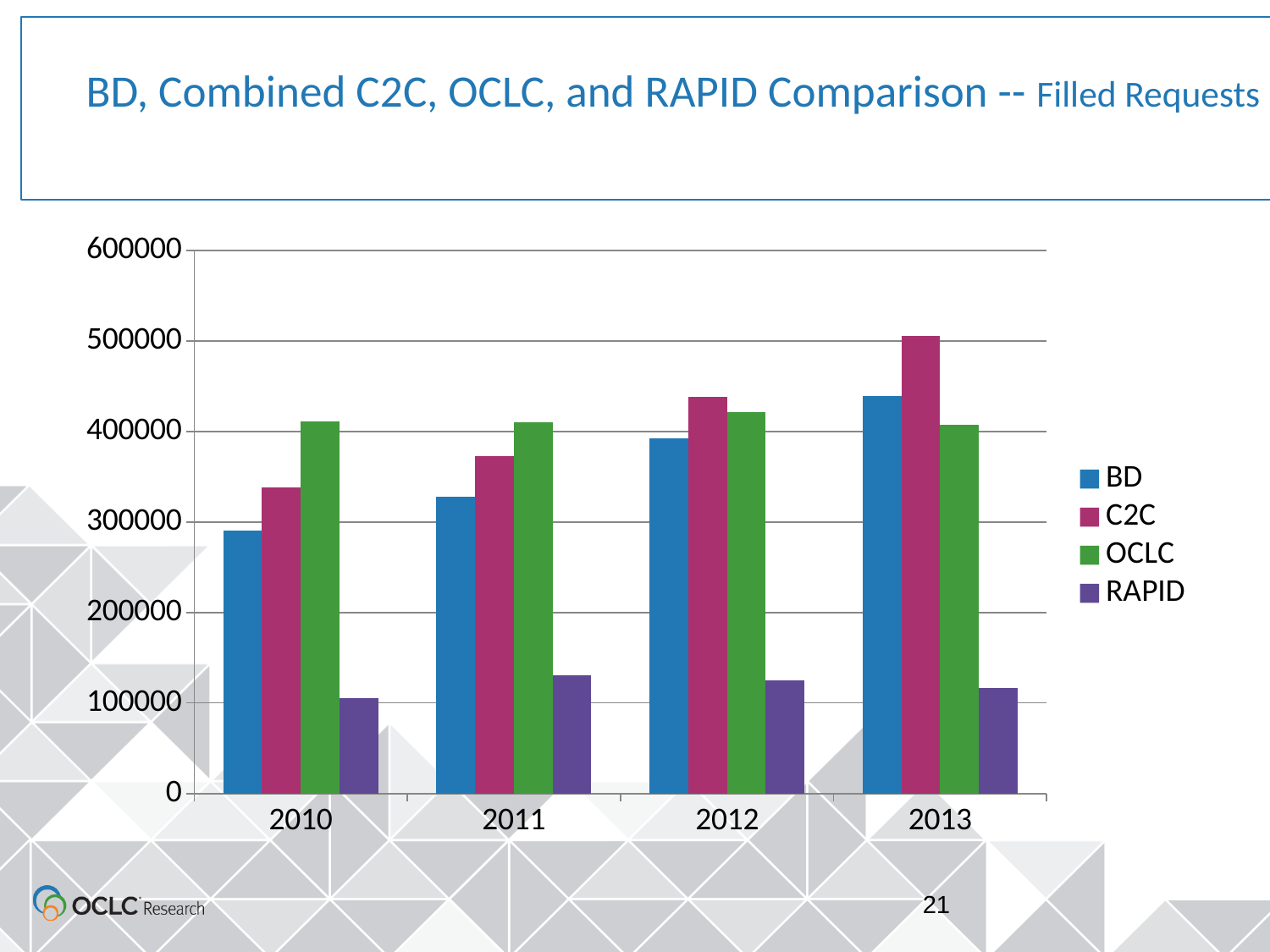
What colour represents OCLC in the legend? green Is the value for RAPID in 2012 greater or less than 200000? less Which series has the highest value in 2010? OCLC Do the BD values rise or fall from 2010 to 2013? rise Which series has the highest value in 2013? C2C Which series has the lowest value in 2010? RAPID How many series does the legend list? 4 Is the value for BD in 2013 greater or less than 400000? greater What kind of chart is shown on the slide? bar chart How many years are shown on the x axis? 4 Is the value for BD in 2010 greater or less than 300000? less In 2010, which is larger, the OCLC value or the C2C value? OCLC